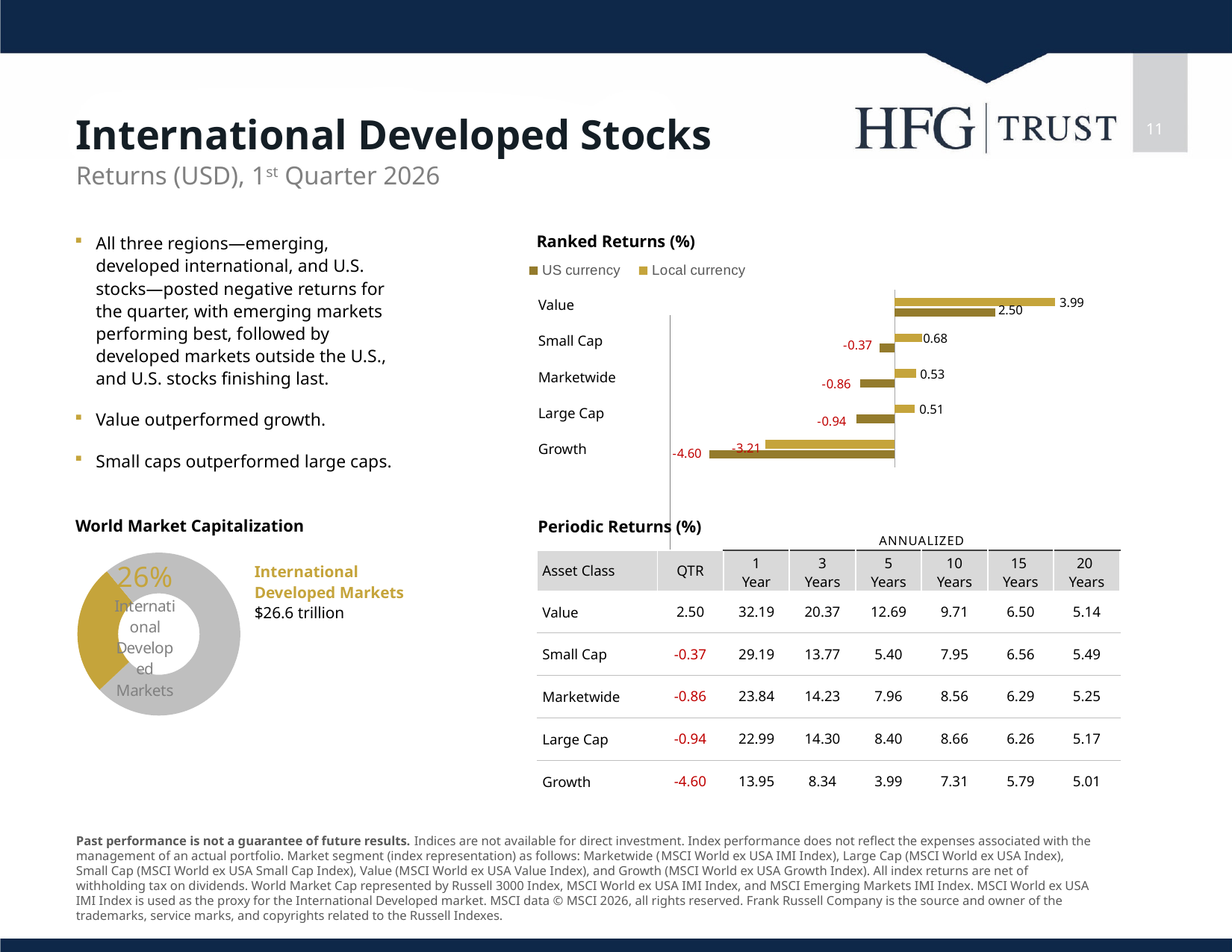
In the Ranked Returns (%) chart, which category has the lowest US currency return? Growth In the Ranked Returns (%) chart, what is the US currency return for Value? 2.50 What kind of chart is the Ranked Returns (%) chart? Bar chart In the World Market Capitalization chart, what share is International Developed Markets? 26% How many series does the legend of the Ranked Returns (%) chart list? 2 In the Ranked Returns (%) chart, which category has the highest Local currency return? Value In the Ranked Returns (%) chart, what is the Local currency return for Growth? -3.21 In the Ranked Returns (%) chart, what is the US currency return for Large Cap? -0.94 How many categories are shown in the Ranked Returns (%) chart? 5 In the Ranked Returns (%) chart, what is the difference between the Local currency and US currency returns for Value? 1.49 What kind of chart is the World Market Capitalization chart? Donut chart In the Ranked Returns (%) chart, which is larger: the US currency return for Small Cap or the US currency return for Marketwide? Small Cap